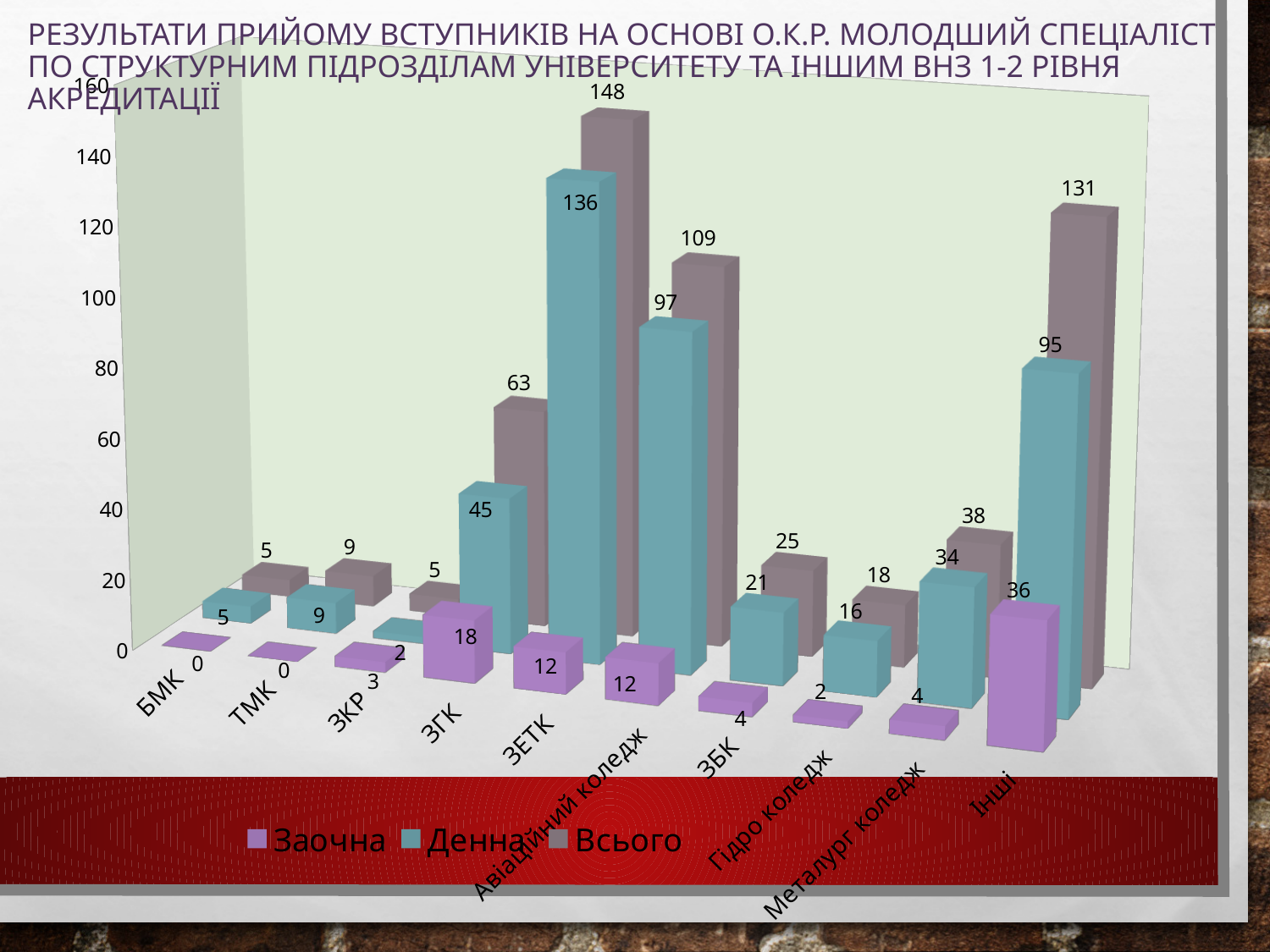
How many series does the legend list? 3 What is the value of Денна for ЗЕТК? 136 What is the value of Заочна for ЗГК? 18 How many categories are shown on the x axis? 10 What is the difference between the Всього values for ЗЕТК and Авіаційний коледж? 39 Which series is shown in purple in the legend? Заочна Which category has the highest Всього value? ЗЕТК Which category has the lowest Денна value? ЗКР What type of chart is shown on the slide? bar chart What is the value of Заочна for Металург коледж? 4 Which is larger, the Денна value for Інші or the Денна value for Авіаційний коледж? Авіаційний коледж What is the value of Всього for Інші? 131